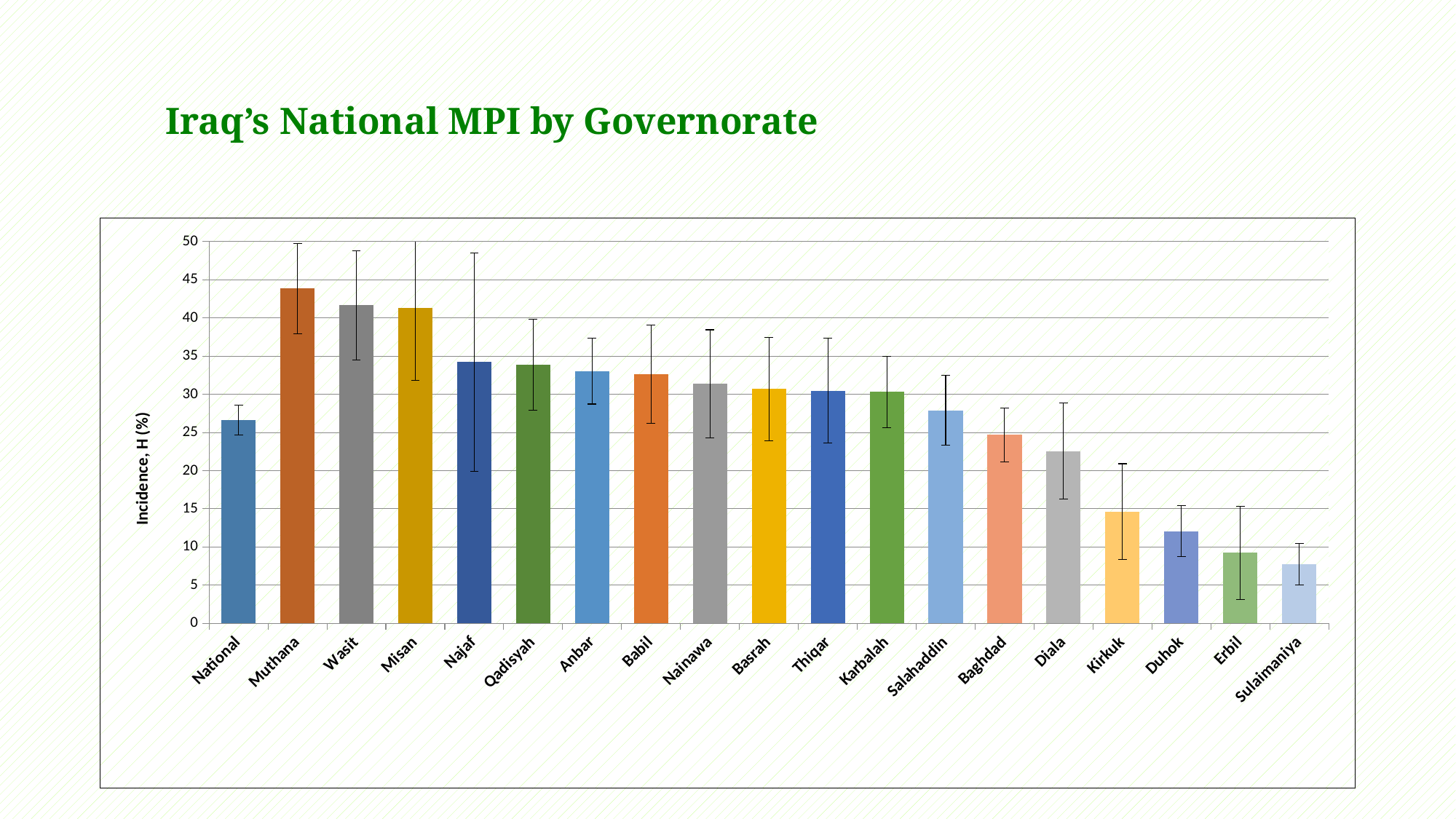
Do the values generally rise or fall along the x axis from Muthana to Sulaimaniya? fall Is the value for Kirkuk greater or less than 20? less Is the value for Muthana greater or less than 40? greater What is the title of the slide? Iraq's National MPI by Governorate Which category has the lowest incidence? Sulaimaniya What kind of chart is shown on the slide? bar chart Which category has the highest incidence? Muthana What is the label on the vertical axis of the chart? Incidence, H (%) Which has a higher incidence, Muthana or Baghdad? Muthana Is the value for Duhok greater or less than 15? less How many categories are shown on the x axis of the chart? 19